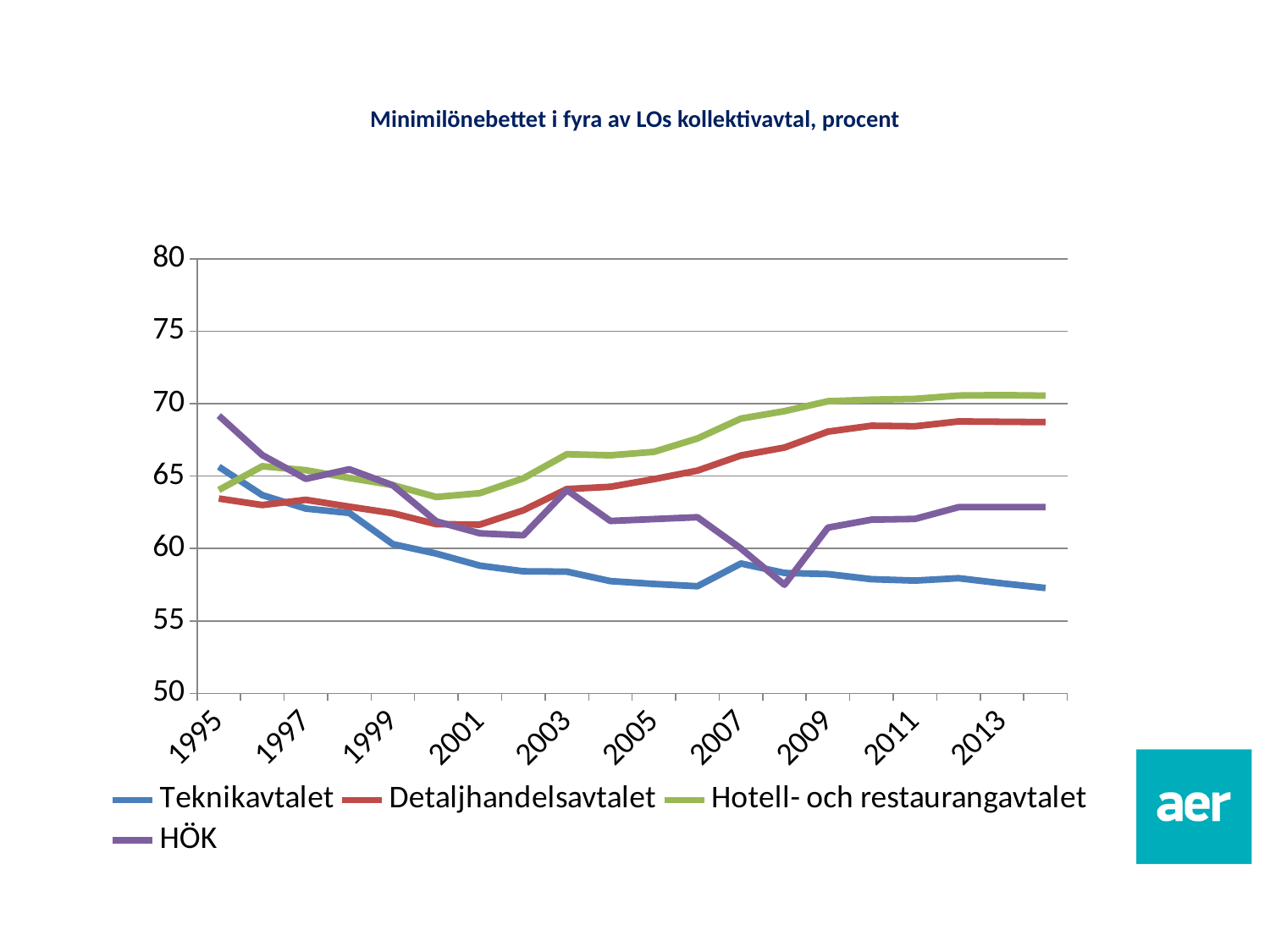
Is the value for HÖK in 1995 greater or less than 65? greater What kind of chart is shown on the slide? line chart Which series has the lowest value in 2013? Teknikavtalet What is the title of the chart? Minimilönebettet i fyra av LOs kollektivavtal, procent How many series does the legend list? 4 In 2009, which is larger: Detaljhandelsavtalet or HÖK? Detaljhandelsavtalet Is the value for Hotell- och restaurangavtalet in 2013 greater or less than 70? greater Which series has the highest value in 2013? Hotell- och restaurangavtalet Does the Teknikavtalet line rise or fall from 1995 to 2013? fall Which series is drawn in green? Hotell- och restaurangavtalet Is the value for Teknikavtalet in 2013 greater or less than 60? less